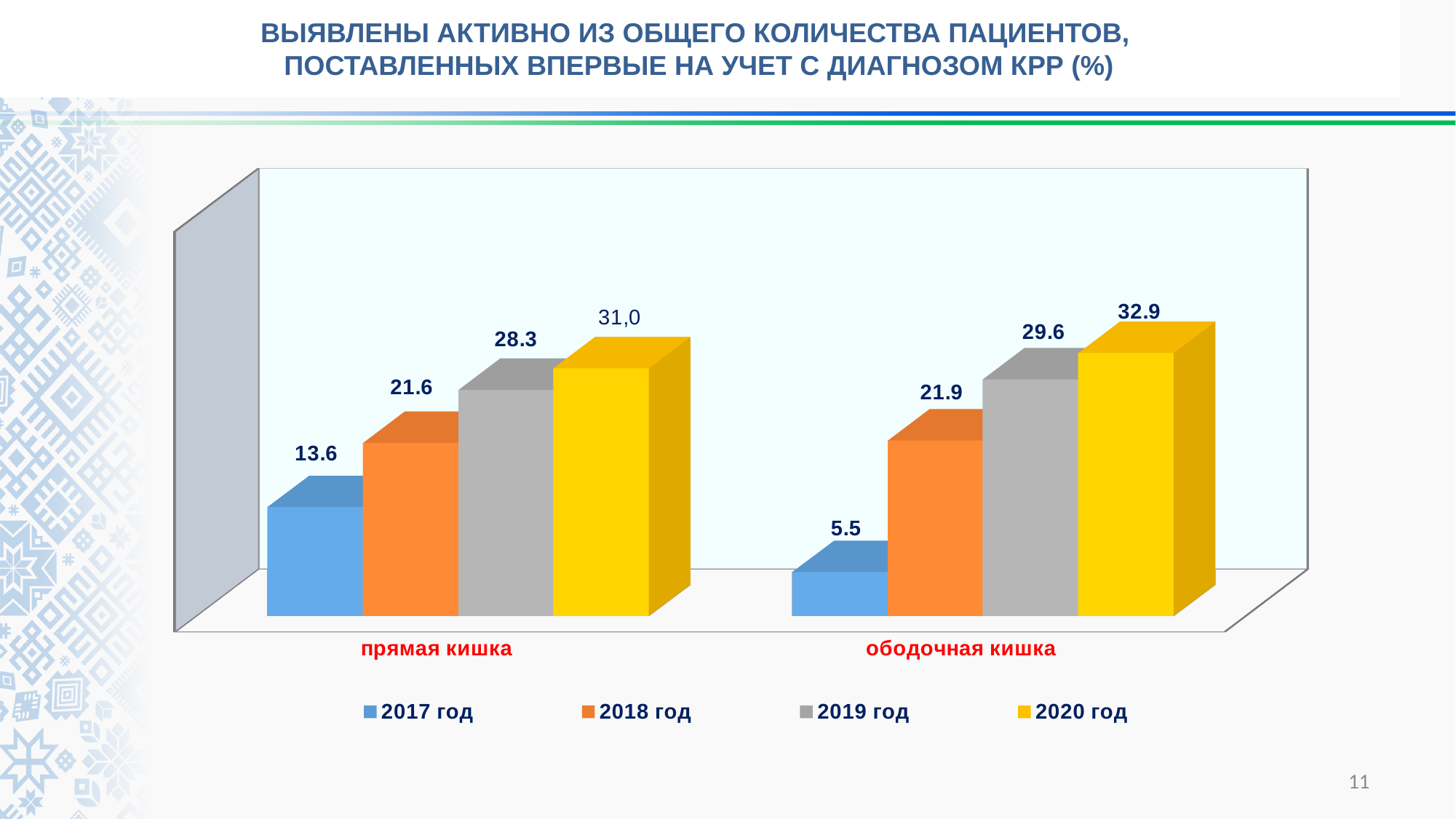
What kind of chart is shown on the slide? bar chart What is the difference between the 2020 год and 2017 год values for ободочная кишка? 27.4 What is the value for 2020 год for ободочная кишка? 32.9 Do the values for ободочная кишка rise or fall from 2017 год to 2020 год? rise What is the value for 2019 год for прямая кишка? 28.3 What is the value for 2018 год for ободочная кишка? 21.9 Which is larger: the 2017 год value for прямая кишка or the 2017 год value for ободочная кишка? прямая кишка Which year has the lowest value for прямая кишка? 2017 год How many categories are shown on the x axis? 2 What is the value for 2017 год for прямая кишка? 13.6 How many series does the legend list? 4 Which year has the highest value for ободочная кишка? 2020 год